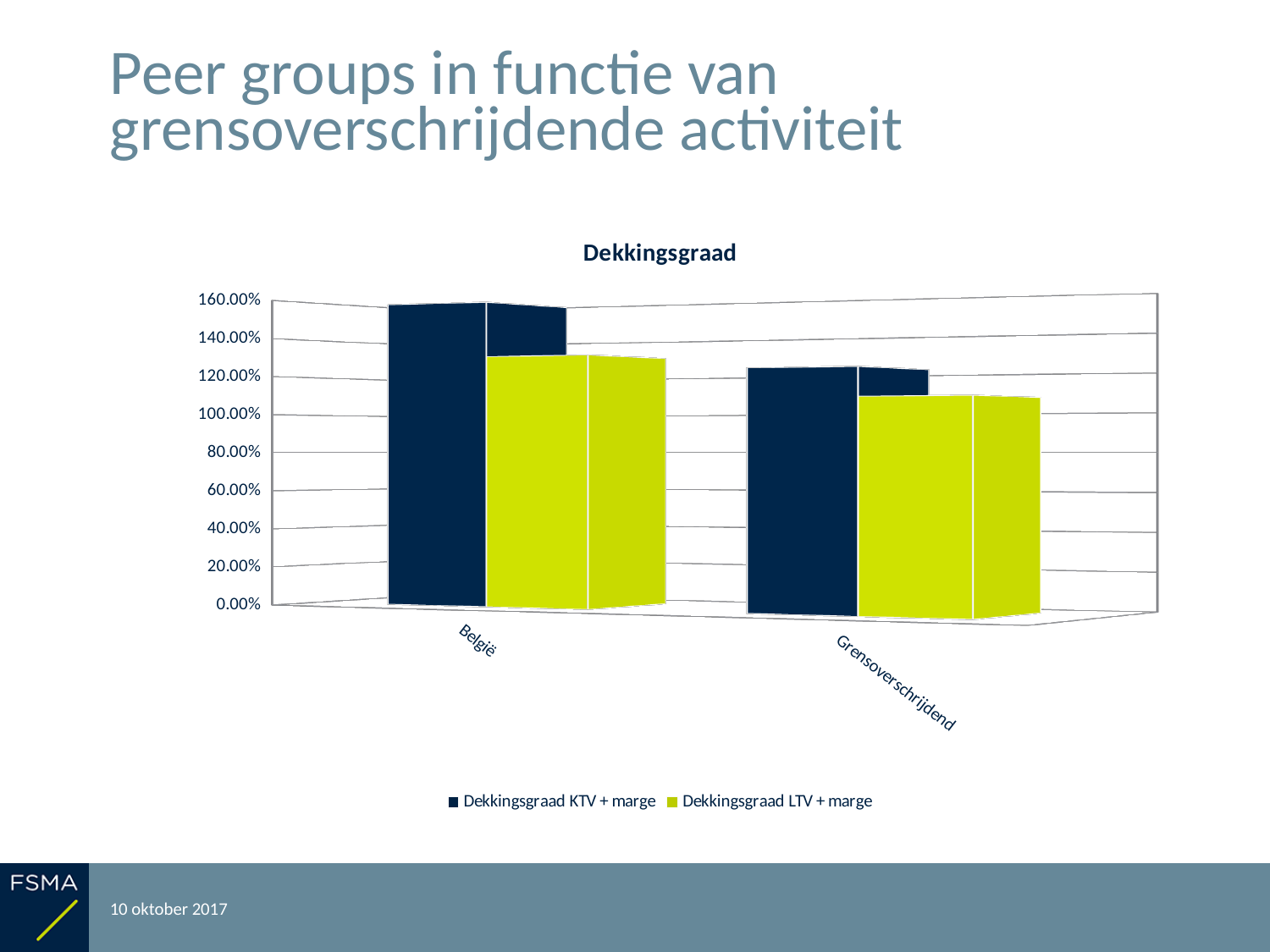
Is the value for Dekkingsgraad LTV + marge for België greater or less than 120.00%? greater How many categories are shown on the x axis? 2 Is the value for Dekkingsgraad LTV + marge for Grensoverschrijdend greater or less than 120.00%? less What is the title of the chart? Dekkingsgraad What type of chart is shown on the slide? bar chart For België, which is larger: Dekkingsgraad KTV + marge or Dekkingsgraad LTV + marge? Dekkingsgraad KTV + marge Which category has the lowest value for Dekkingsgraad LTV + marge? Grensoverschrijdend Which series is shown in dark navy? Dekkingsgraad KTV + marge Is the value for Dekkingsgraad KTV + marge for België greater or less than 140.00%? greater Which category has the highest value for Dekkingsgraad KTV + marge? België How many series does the legend list? 2